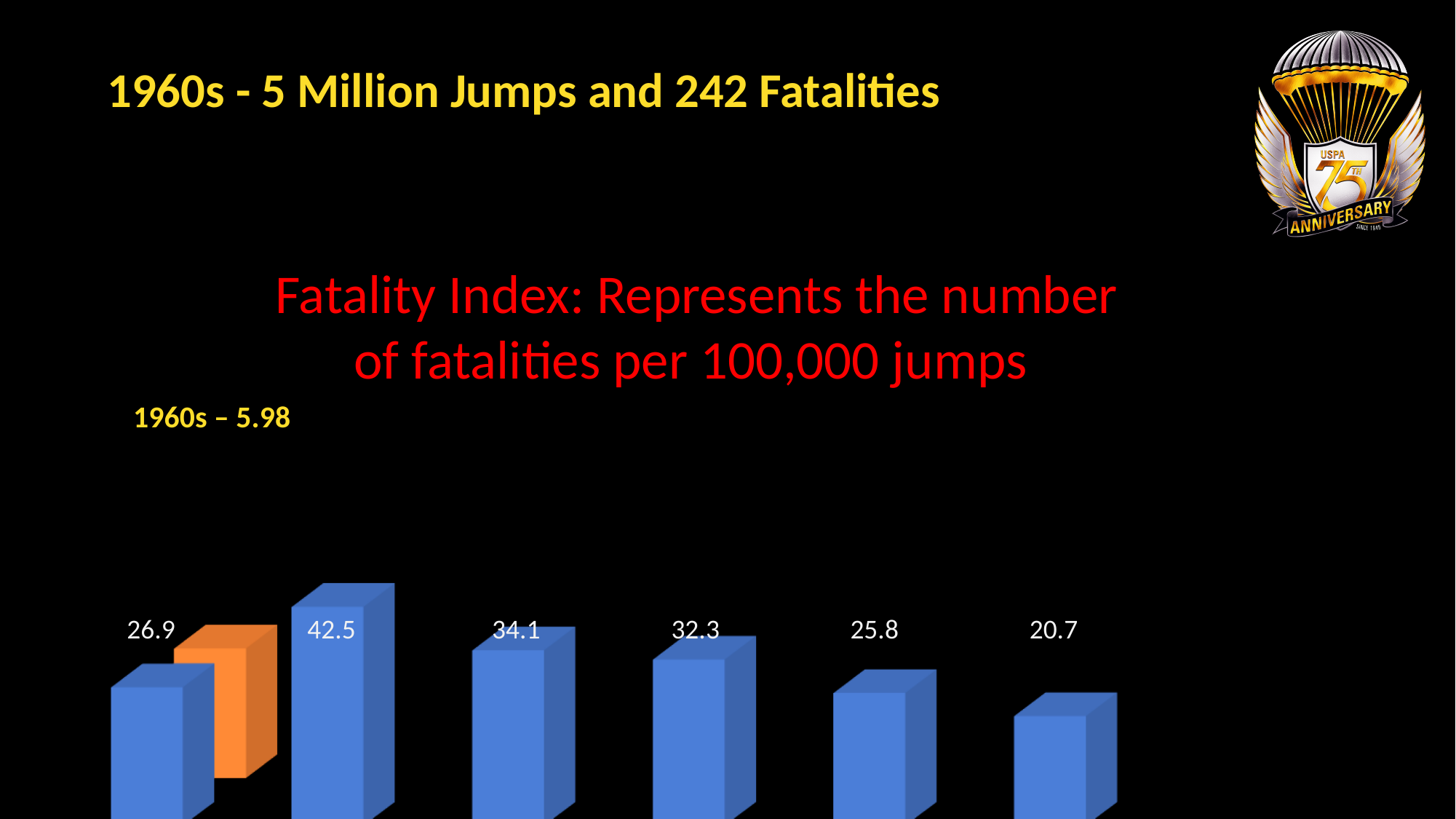
What is the lowest value printed on the chart? 20.7 What is the difference between the bar labelled 25.8 and the bar labelled 20.7? 5.1 What colour are the bars that have printed data labels? blue Do the labelled values rise or fall from the tallest bar (42.5) to the rightmost bar? fall What is the difference between the bar labelled 42.5 and the bar labelled 34.1? 8.4 What is the value printed above the rightmost bar? 20.7 What is the value printed above the tallest bar? 42.5 What colour is the bar that has no printed data label? orange How many bars on the chart have a printed data label? 6 What kind of chart is shown on the slide? bar chart Which is larger, the bar labelled 34.1 or the bar labelled 32.3? 34.1 What is the value printed above the leftmost blue bar? 26.9